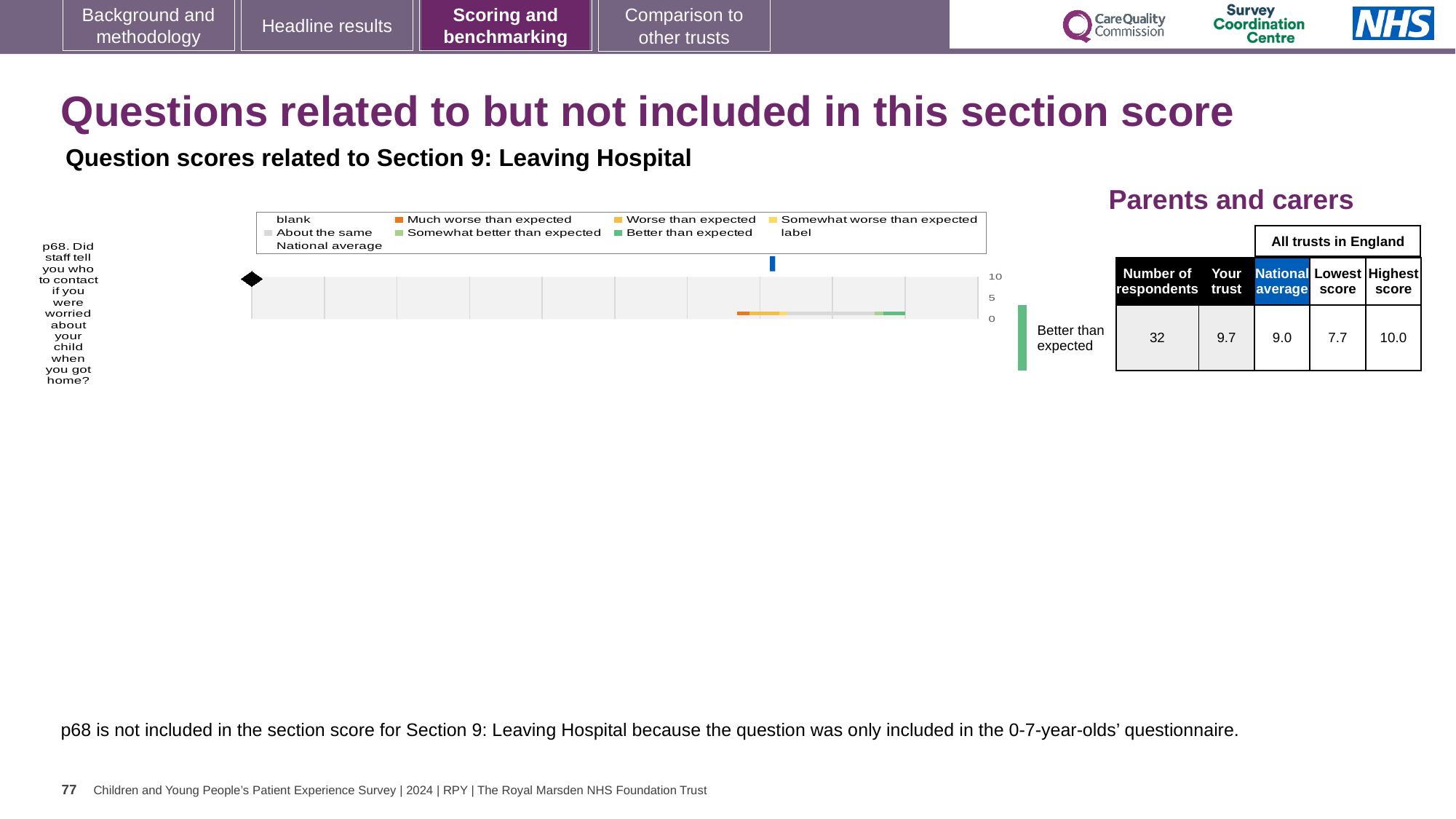
What is the Lowest score among all trusts in England for p68? 7.7 Is the 'Your trust' score for p68 higher or lower than the National average? higher How many respondents answered p68 in the Parents and carers table? 32 Which question is plotted in the chart on the slide? p68. Did staff tell you who to contact if you were worried about your child when you got home? What is the National average score for p68 in the Parents and carers table? 9.0 What rating label is shown beside the chart for the trust's result on p68? Better than expected Is the trust's score for p68 greater or less than 5 on the chart's axis? greater What is the difference between the 'Your trust' score and the National average for p68? 0.7 What is the Highest score among all trusts in England for p68? 10.0 What is the highest tick value shown on the chart's axis? 10 What kind of chart is shown on the slide for question p68? bar chart What is the 'Your trust' score for p68 in the Parents and carers table? 9.7